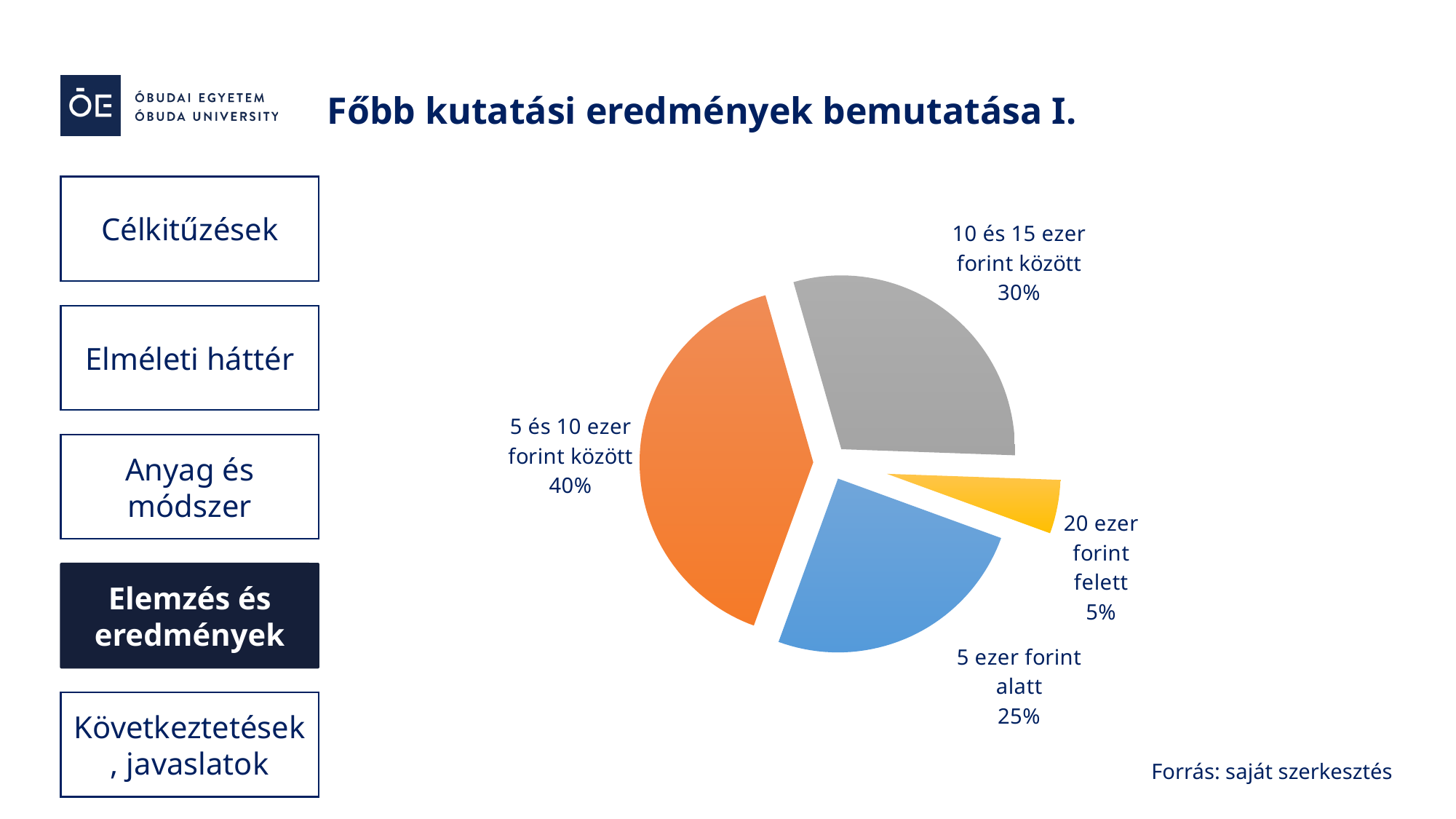
What share of the pie does the "10 és 15 ezer forint között" slice have? 30% What share of the pie does the "5 és 10 ezer forint között" slice have? 40% Which category has the largest slice of the pie? 5 és 10 ezer forint között What colour is the "5 ezer forint alatt" slice? blue What kind of chart is shown on the slide? pie chart What is the source note shown below the chart? Forrás: saját szerkesztés What is the difference in percentage points between the "5 és 10 ezer forint között" slice and the "5 ezer forint alatt" slice? 15 How many slices does the pie chart have? 4 Which slice is larger: "10 és 15 ezer forint között" or "5 ezer forint alatt"? 10 és 15 ezer forint között Which category has the smallest slice of the pie? 20 ezer forint felett What share of the pie does the "20 ezer forint felett" slice have? 5%